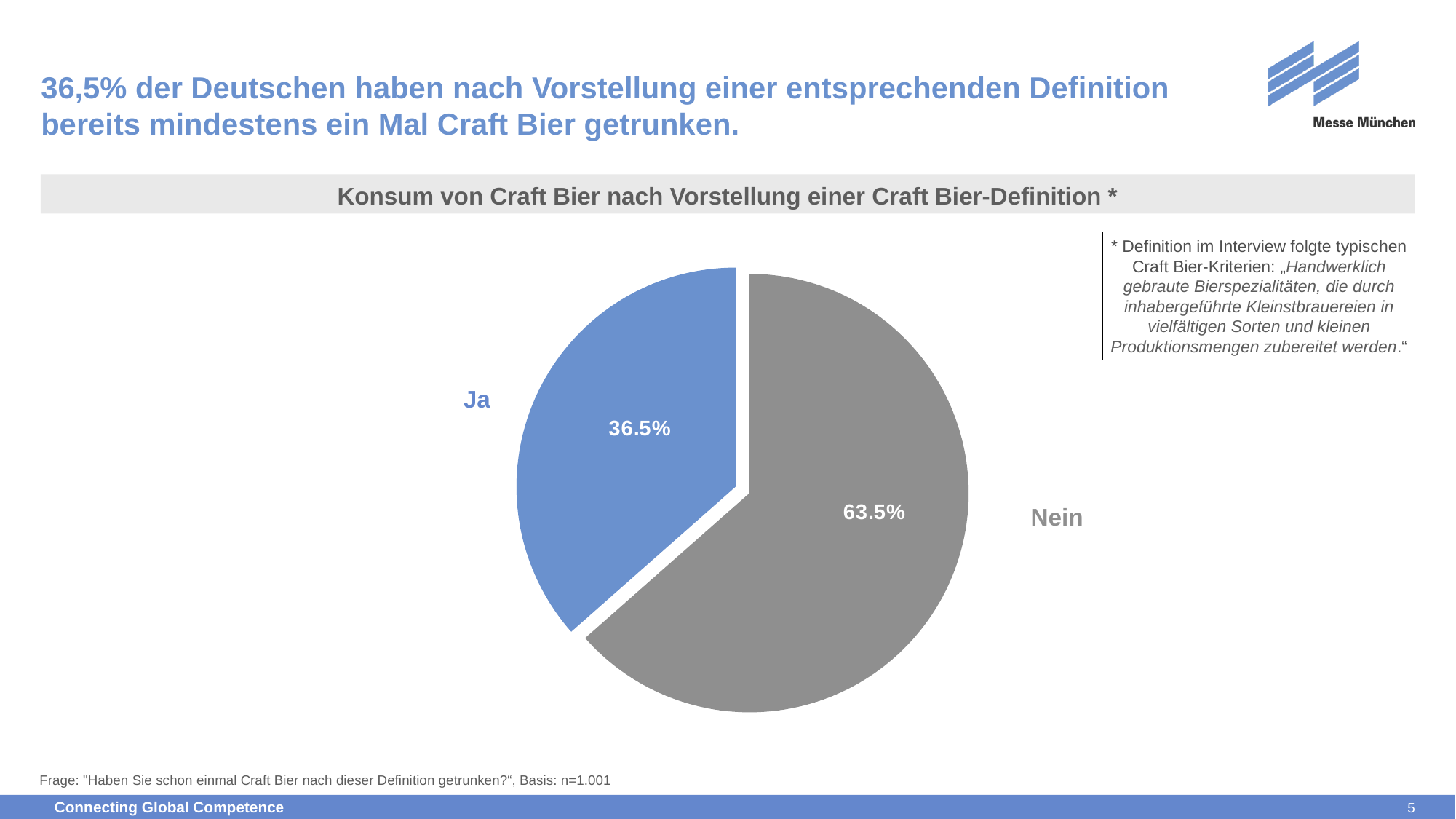
What is the value for "Ja" in the pie chart? 36.5% Which category has the smallest share of the pie? Ja Which category has the largest share of the pie? Nein What is the difference between the "Nein" and "Ja" shares? 27.0% Which is larger, the share for "Ja" or the share for "Nein"? Nein What is the title of the chart? Konsum von Craft Bier nach Vorstellung einer Craft Bier-Definition * How many slices does the pie chart have? 2 What type of chart is shown on the slide? Pie chart What colour is the "Ja" slice of the pie chart? Blue What is the value for "Nein" in the pie chart? 63.5% What share of the pie does the "Ja" slice represent? 36.5%